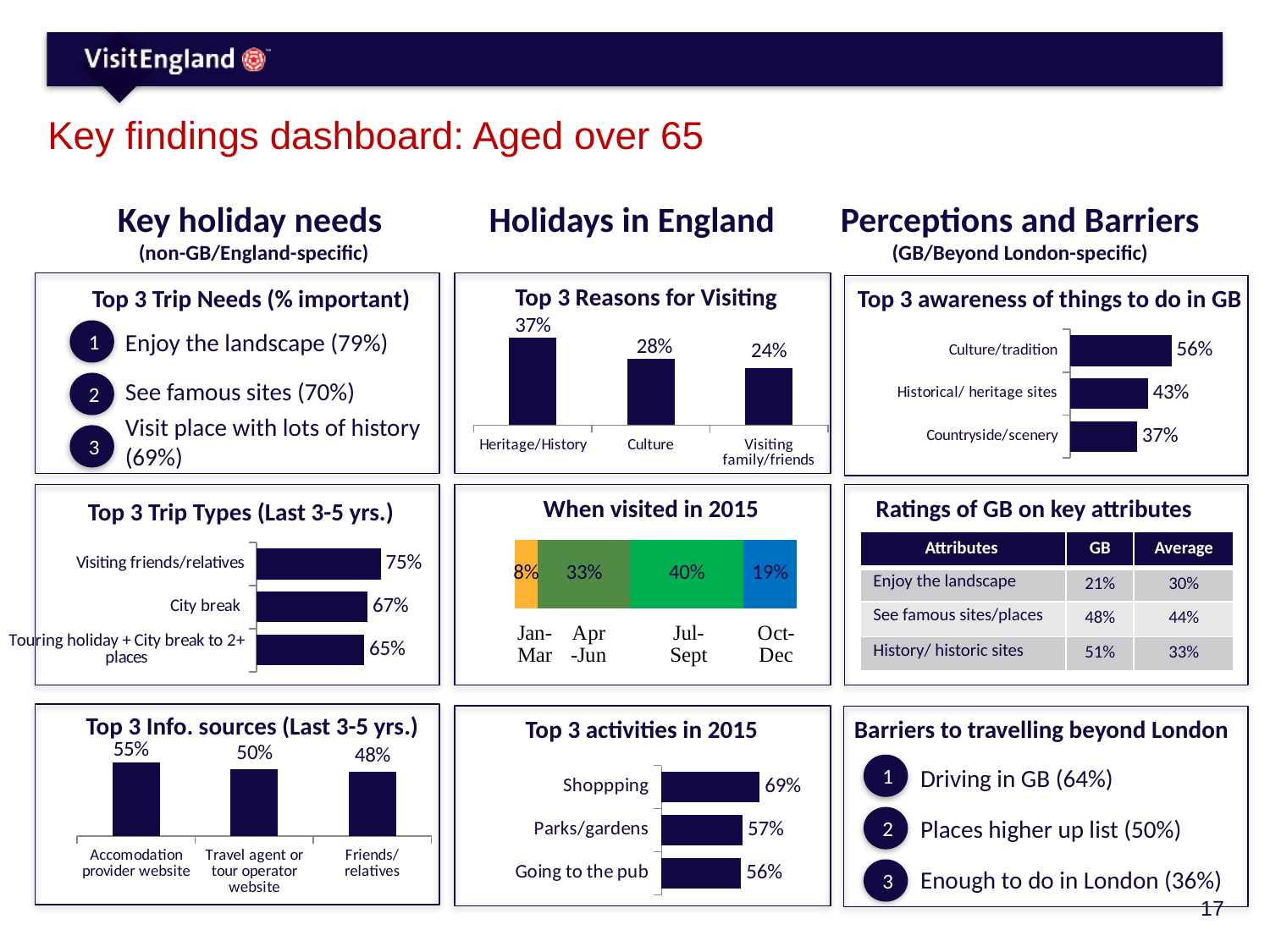
In the 'Top 3 Reasons for Visiting' chart, what is the value for Heritage/History? 37% In the 'Top 3 Trip Types (Last 3-5 yrs.)' chart, which category has the highest value? Visiting friends/relatives In the 'Top 3 activities in 2015' chart, which is larger, Shopping or Going to the pub? Shopping In the 'When visited in 2015' chart, what is the value for Jul-Sept? 40% In the 'Top 3 Info. sources (Last 3-5 yrs.)' chart, do the values rise or fall from left to right? fall In the 'Top 3 awareness of things to do in GB' chart, what is the difference between Culture/tradition and Countryside/scenery? 19% In the 'Top 3 awareness of things to do in GB' chart, what is the value for Historical/ heritage sites? 43% In the 'When visited in 2015' chart, how many time periods are shown? 4 What kind of chart is the 'Top 3 activities in 2015' chart? bar chart In the 'Top 3 Info. sources (Last 3-5 yrs.)' chart, what is the value for Friends/relatives? 48% In the 'Top 3 Trip Types (Last 3-5 yrs.)' chart, what is the value for City break? 67% In the 'Top 3 Reasons for Visiting' chart, which category has the lowest value? Visiting family/friends